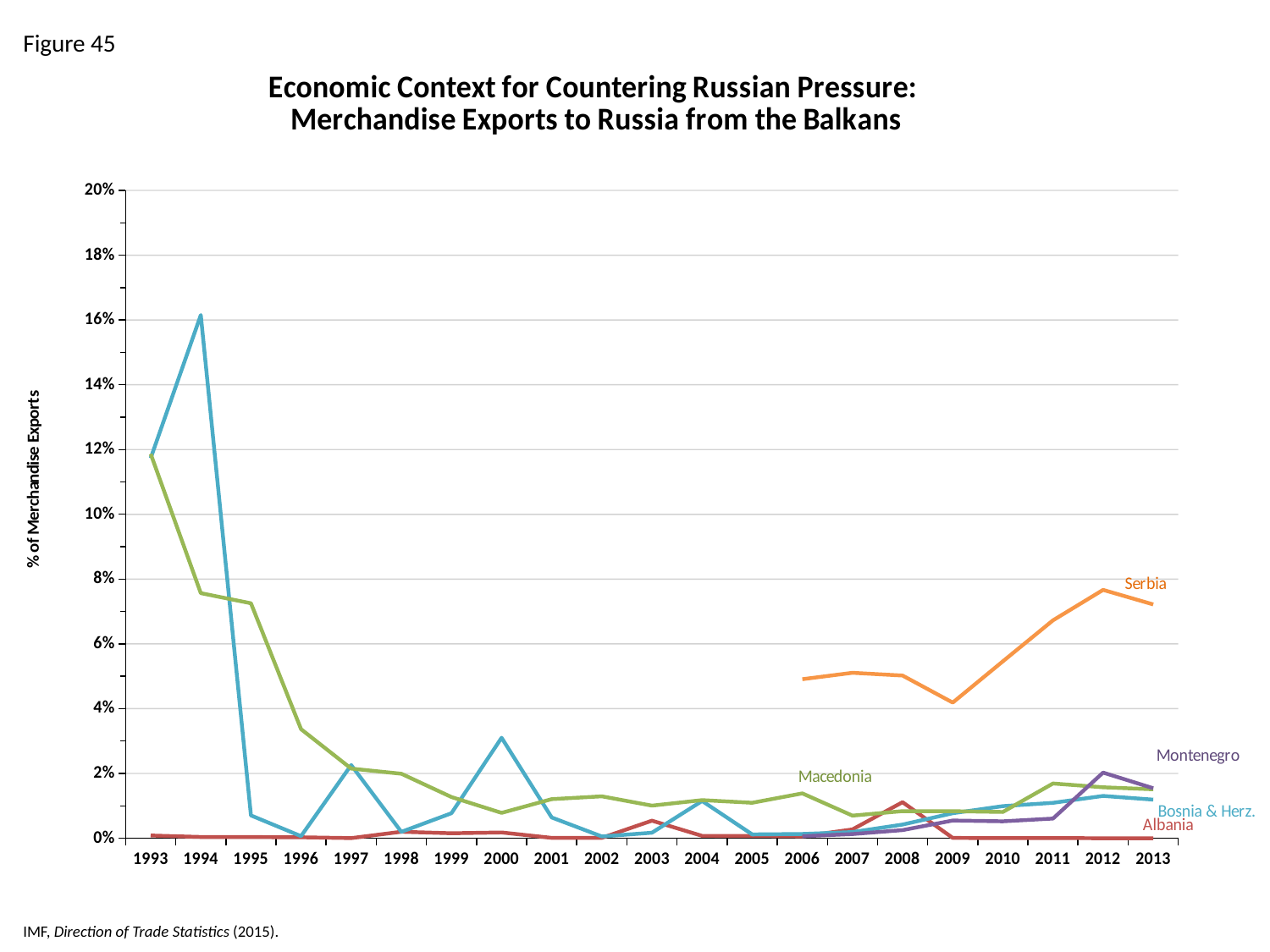
Does the Serbia line rise or fall between 2009 and 2012? rise What kind of chart is shown on the slide? line chart Which country has the highest value in 2013? Serbia Which country has the lowest value in 2013? Albania How many years are shown along the x axis? 21 Is the value for Bosnia & Herz. in 1994 greater or less than 14%? greater Is the value for Macedonia in 1995 greater or less than 8%? less How many countries are plotted as series on the chart? 5 Which country has the highest value in 1994? Bosnia & Herz. In which year does the Bosnia & Herz. line reach its peak? 1994 In which year is the Serbia line at its lowest? 2009 Is the value for Serbia in 2012 greater or less than 6%? greater